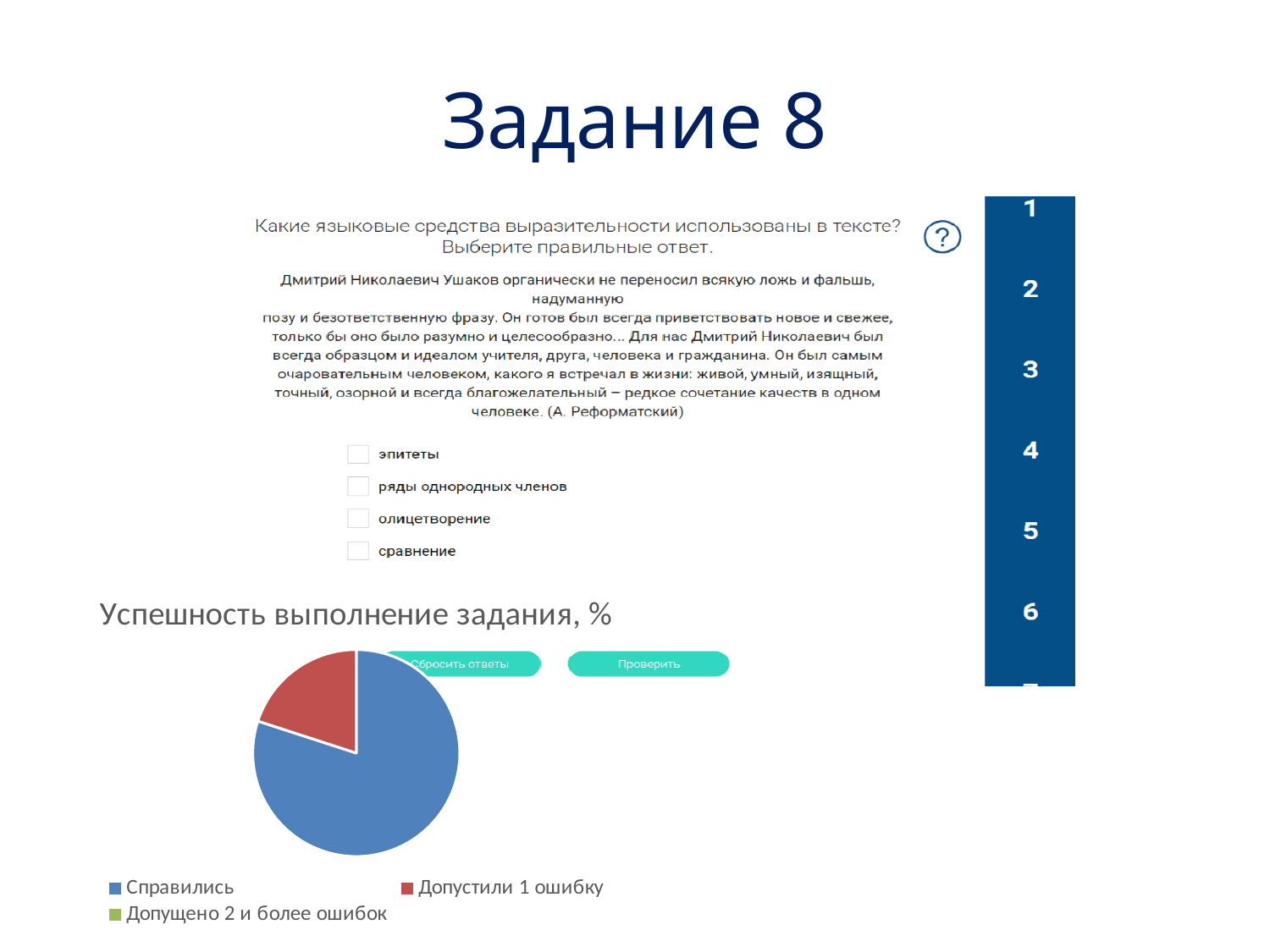
How many entries does the chart's legend list? 3 What kind of chart is shown on the slide? pie chart Which is larger: the slice for Справились or the slice for Допустили 1 ошибку? Справились What colour is the slice for Справились? blue What is the title of the chart? Успешность выполнение задания, % Which category has the largest slice of the pie? Справились Which legend entry is shown in red? Допустили 1 ошибку